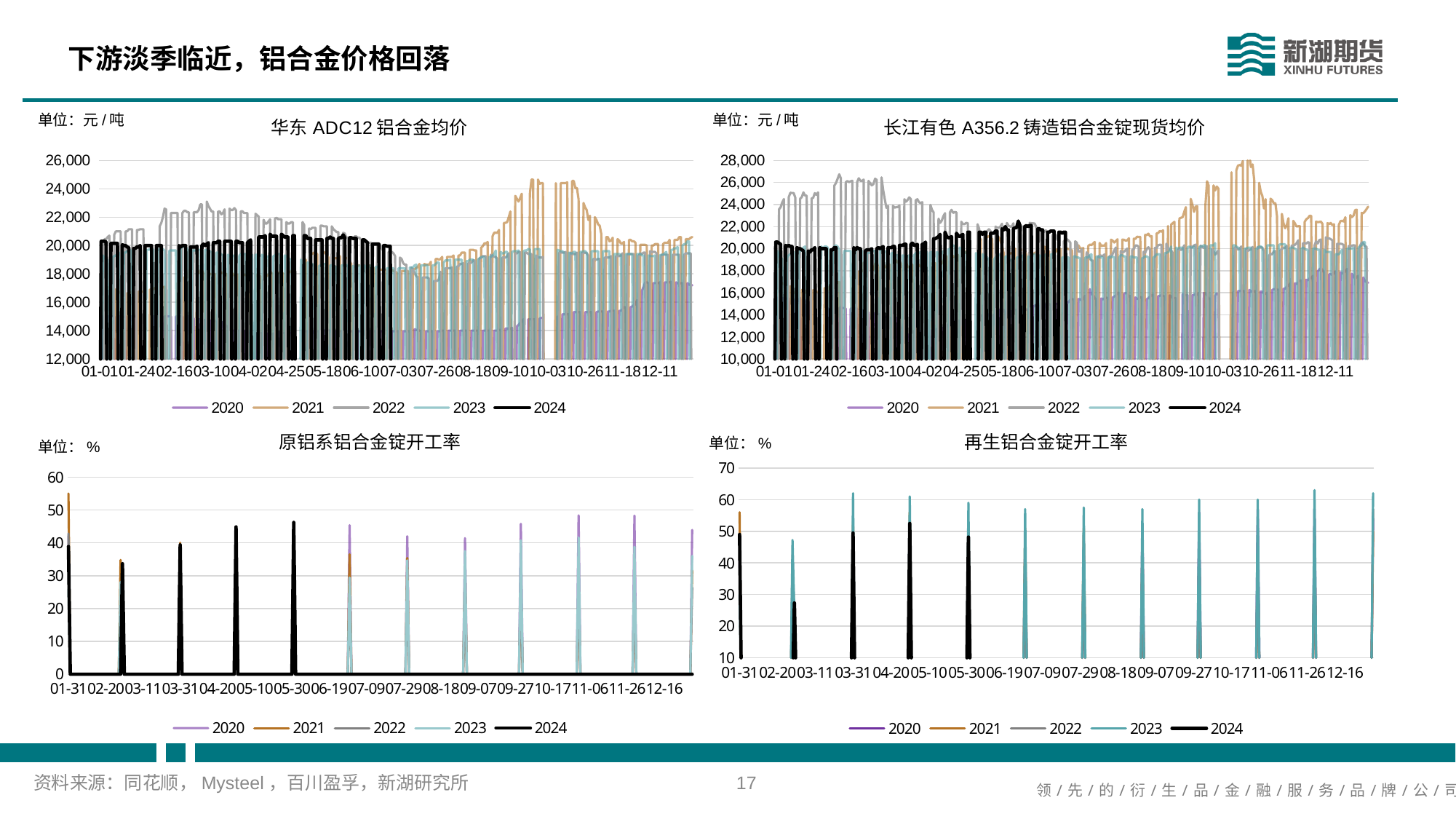
In the bottom-left chart (原铝系铝合金锭开工率), is the 2024 peak near 05-30 greater or less than 40? greater In the bottom-right chart (再生铝合金锭开工率), is the 2024 peak near 02-20 greater or less than 40? less What unit is shown for the bottom-left chart titled 原铝系铝合金锭开工率? % How many series does the legend of the top-left chart (华东 ADC12 铝合金均价) list? 5 What kind of chart is the bottom-right chart titled 再生铝合金锭开工率? line chart In the bottom-right chart (再生铝合金锭开工率), is the 2023 peak near 03-31 greater or less than 60? greater What kind of chart is the top-left chart titled 华东 ADC12 铝合金均价? line chart How many series does the legend of the bottom-right chart (再生铝合金锭开工率) list? 5 In the top-right chart (长江有色 A356.2 铸造铝合金锭现货均价), which year is drawn as the thick black line? 2024